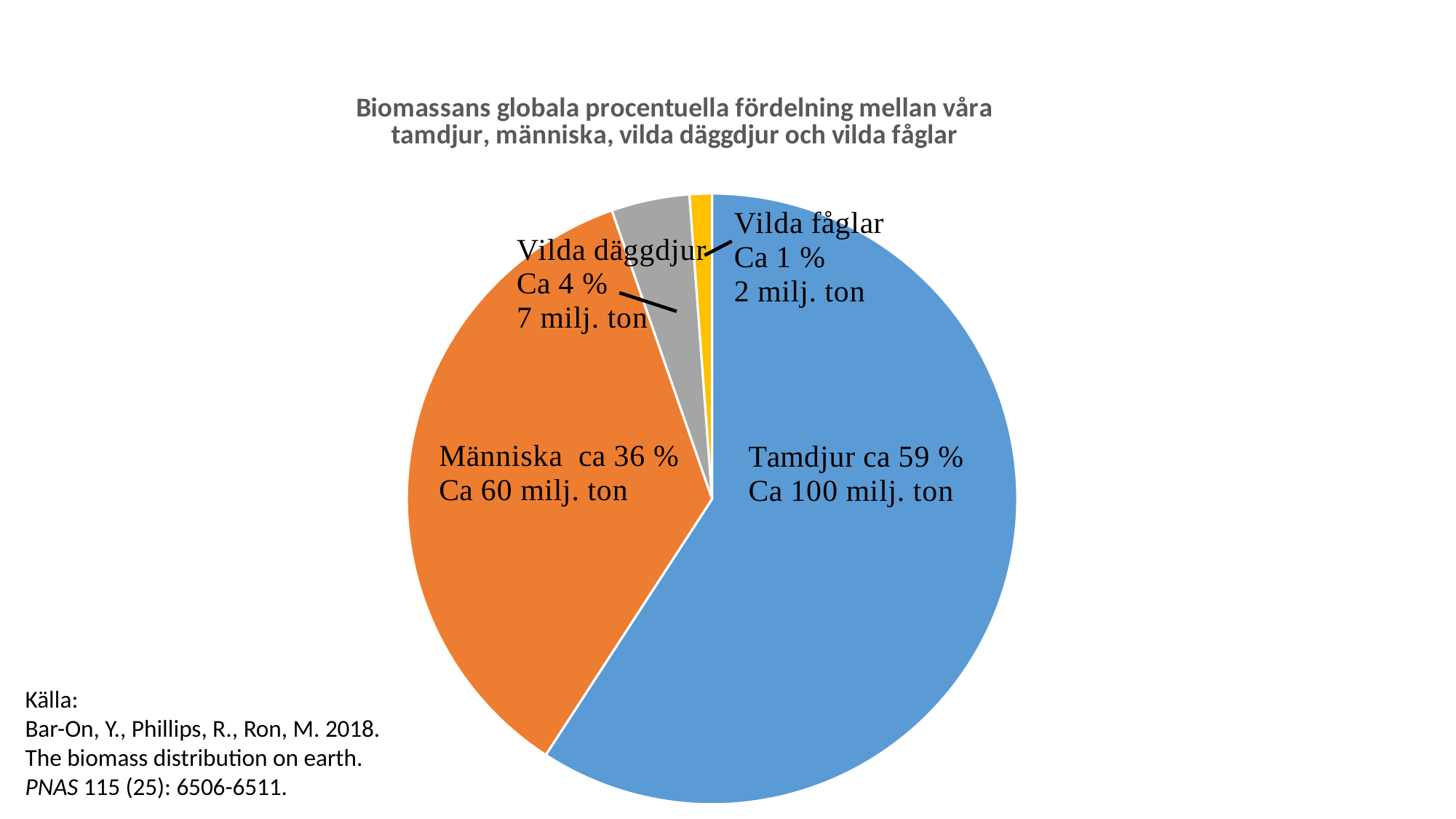
What colour is the Tamdjur slice of the pie? blue Which category has the smallest slice of the pie? Vilda fåglar Which category has the largest slice of the pie? Tamdjur Which has the larger share of biomass, Människa or Vilda däggdjur? Människa What percentage share is labelled for Vilda däggdjur? Ca 4 % How many million tonnes of biomass are labelled for Tamdjur? Ca 100 milj. ton What percentage share of the biomass is labelled for Människa? ca 36 % How many slices does the pie chart have? 4 What percentage share of the biomass is labelled for Tamdjur? ca 59 % What kind of chart is shown on the slide? pie chart How many million tonnes of biomass are labelled for Vilda fåglar? 2 milj. ton What is the difference in million tonnes between Tamdjur (100) and Människa (60)? 40 milj. ton